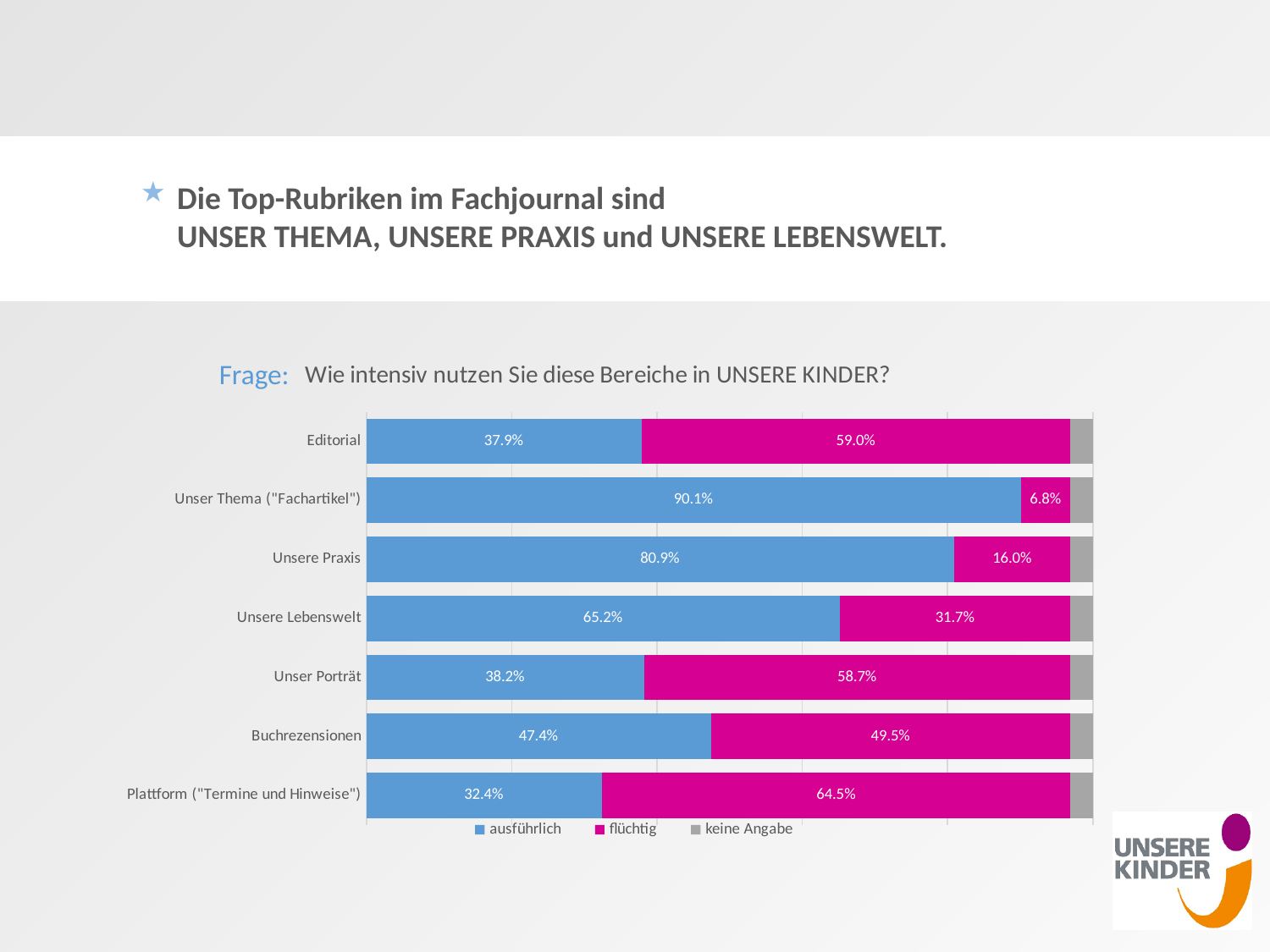
How many series does the legend list? 3 What is the "flüchtig" value for Unsere Praxis? 16.0% Which series is shown in magenta? flüchtig What is the "ausführlich" value for Plattform ("Termine und Hinweise")? 32.4% What is the "ausführlich" value for Unser Thema ("Fachartikel")? 90.1% What is the "flüchtig" value for Editorial? 59.0% How many categories are shown on the chart? 7 Which category has the lowest "ausführlich" value? Plattform ("Termine und Hinweise") Which is larger: the "flüchtig" value for Buchrezensionen or the "flüchtig" value for Unser Porträt? Unser Porträt What kind of chart is shown on the slide? Stacked bar chart What is the difference between the "ausführlich" values for Unsere Praxis and Unsere Lebenswelt? 15.7% Which category has the highest "ausführlich" value? Unser Thema ("Fachartikel")